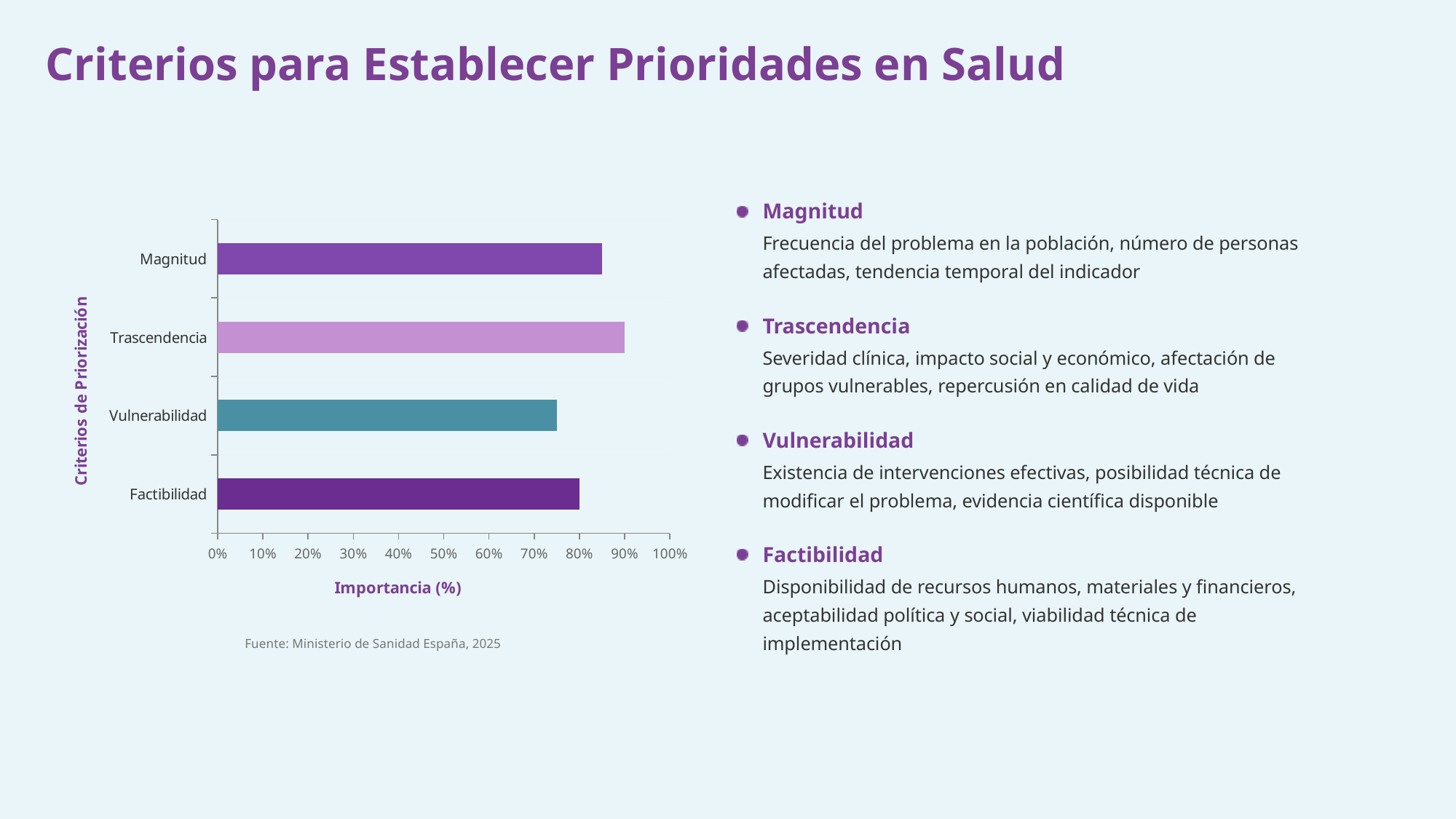
What is the difference between the values for Trascendencia and Factibilidad? 10% What kind of chart is shown on the slide? Bar chart Is the value for Vulnerabilidad greater or less than 80%? less How many criteria (categories) are plotted in the chart? 4 What is the value for Trascendencia? 90% What is the title of the horizontal axis of the chart? Importancia (%) What is the value for Factibilidad? 80% Which has a larger value, Magnitud or Factibilidad? Magnitud Is the value for Magnitud greater or less than 80%? greater What is the title of the vertical axis of the chart? Criterios de Priorización Which criterion has the lowest value? Vulnerabilidad Which criterion has the highest value? Trascendencia